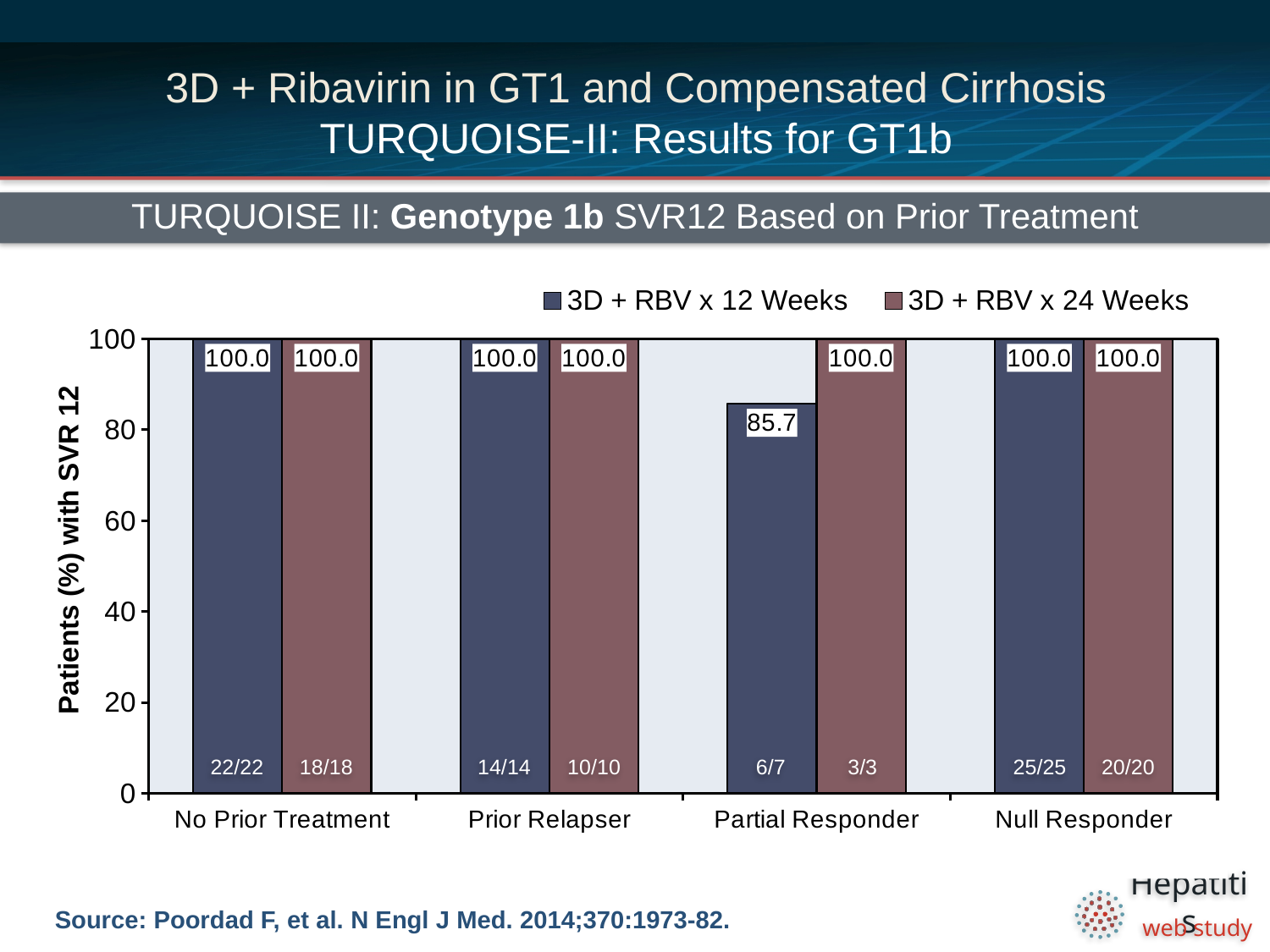
Which prior treatment category has the lowest SVR12 rate for 3D + RBV x 12 Weeks? Partial Responder How many patients achieved SVR12 in the No Prior Treatment group with 3D + RBV x 12 Weeks, as shown by the fraction label? 22/22 How many prior treatment categories are shown on the x axis? 4 What fraction label is shown for Partial Responder patients treated with 3D + RBV x 24 Weeks? 3/3 Is the SVR12 rate for Partial Responder patients treated with 3D + RBV x 12 Weeks greater or less than 80? greater What is the difference between the 3D + RBV x 24 Weeks and 3D + RBV x 12 Weeks SVR12 rates for Partial Responder patients? 14.3 What is the label of the y axis? Patients (%) with SVR 12 What is the SVR12 rate for Partial Responder patients treated with 3D + RBV x 12 Weeks? 85.7 What is the SVR12 rate for Null Responder patients treated with 3D + RBV x 24 Weeks? 100.0 For Partial Responder patients, which regimen has the higher SVR12 rate, 3D + RBV x 12 Weeks or 3D + RBV x 24 Weeks? 3D + RBV x 24 Weeks How many series does the legend list? 2 What kind of chart is shown on the slide? Bar chart